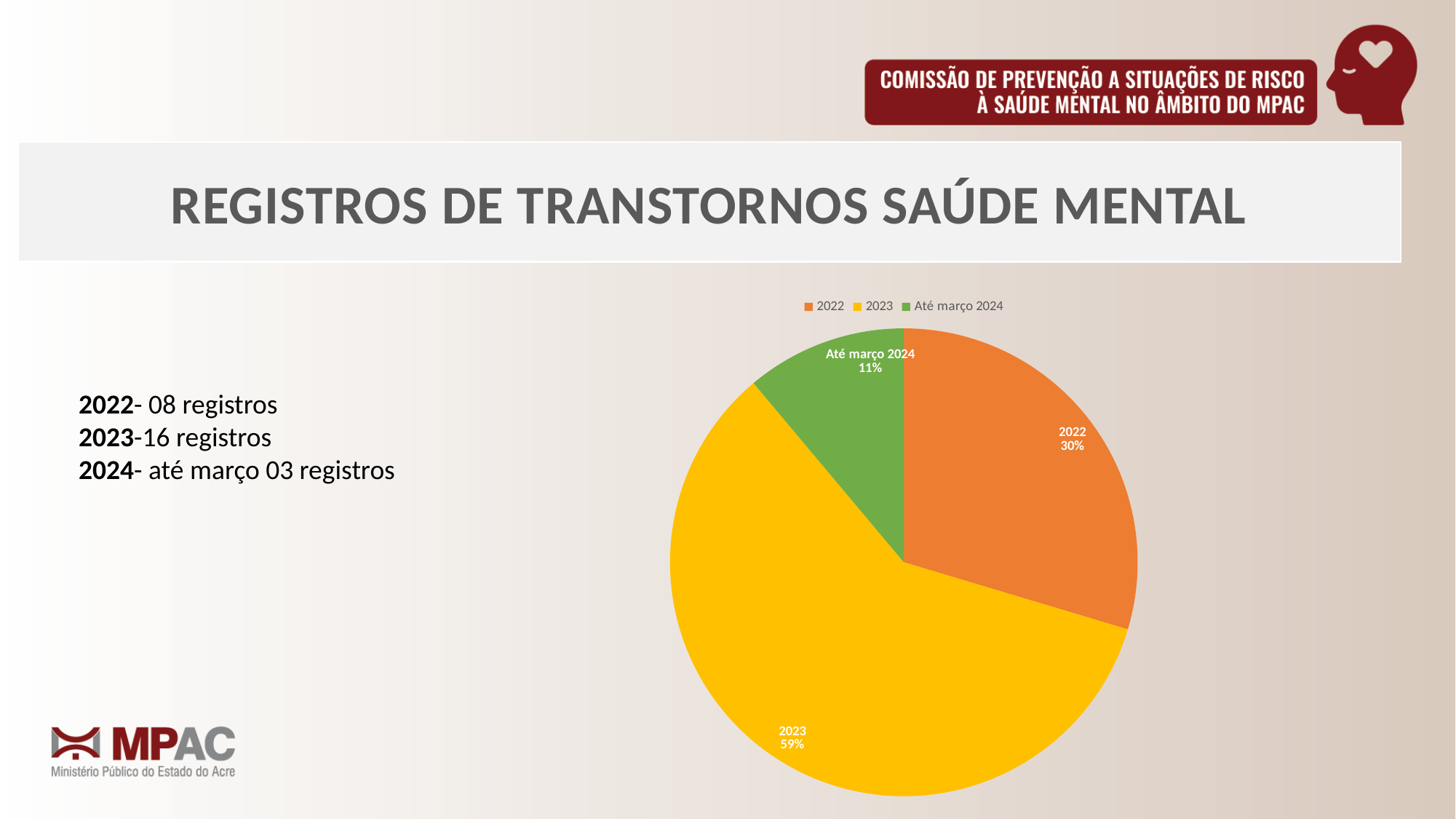
Which slice of the pie chart is the smallest? Até março 2024 What colour is the 'Até março 2024' slice in the pie chart? green What share of the pie does the 'Até março 2024' slice represent? 11% What share of the pie does the 2022 slice represent? 30% What colour is the 2023 slice in the pie chart? yellow How many entries does the legend of the pie chart list? 3 Which slice is larger, 2022 or 'Até março 2024'? 2022 What is the difference in percentage points between the 2023 slice and the 2022 slice? 29 What share of the pie does the 2023 slice represent? 59% Which slice of the pie chart is the largest? 2023 How many slices does the pie chart have? 3 What kind of chart is shown on the slide? pie chart